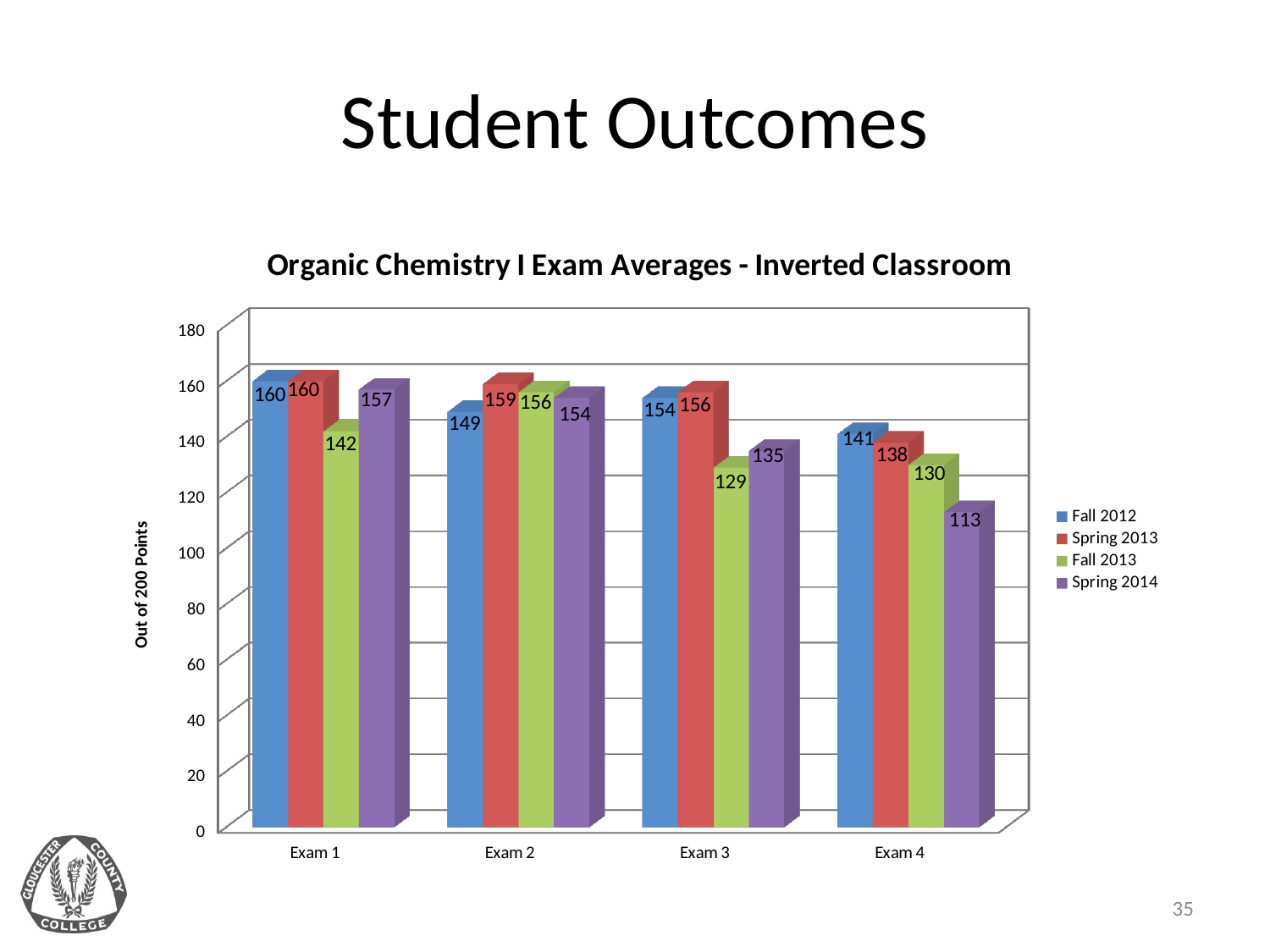
Which exam has the highest Fall 2013 average? Exam 2 How many series does the legend list? 4 Which exam has the lowest Spring 2014 average? Exam 4 Do the Fall 2012 averages rise or fall from Exam 1 to Exam 4? Fall What is the Fall 2013 exam average for Exam 1? 142 What is the title of the chart? Organic Chemistry I Exam Averages - Inverted Classroom What is the difference between the Fall 2012 and Spring 2014 averages for Exam 4? 28 What is the Spring 2013 exam average for Exam 2? 159 Which is larger for Exam 3: the Spring 2013 average or the Fall 2013 average? Spring 2013 What kind of chart is shown on the slide? Bar chart How many exams are shown on the x axis? 4 What is the Spring 2014 exam average for Exam 4? 113